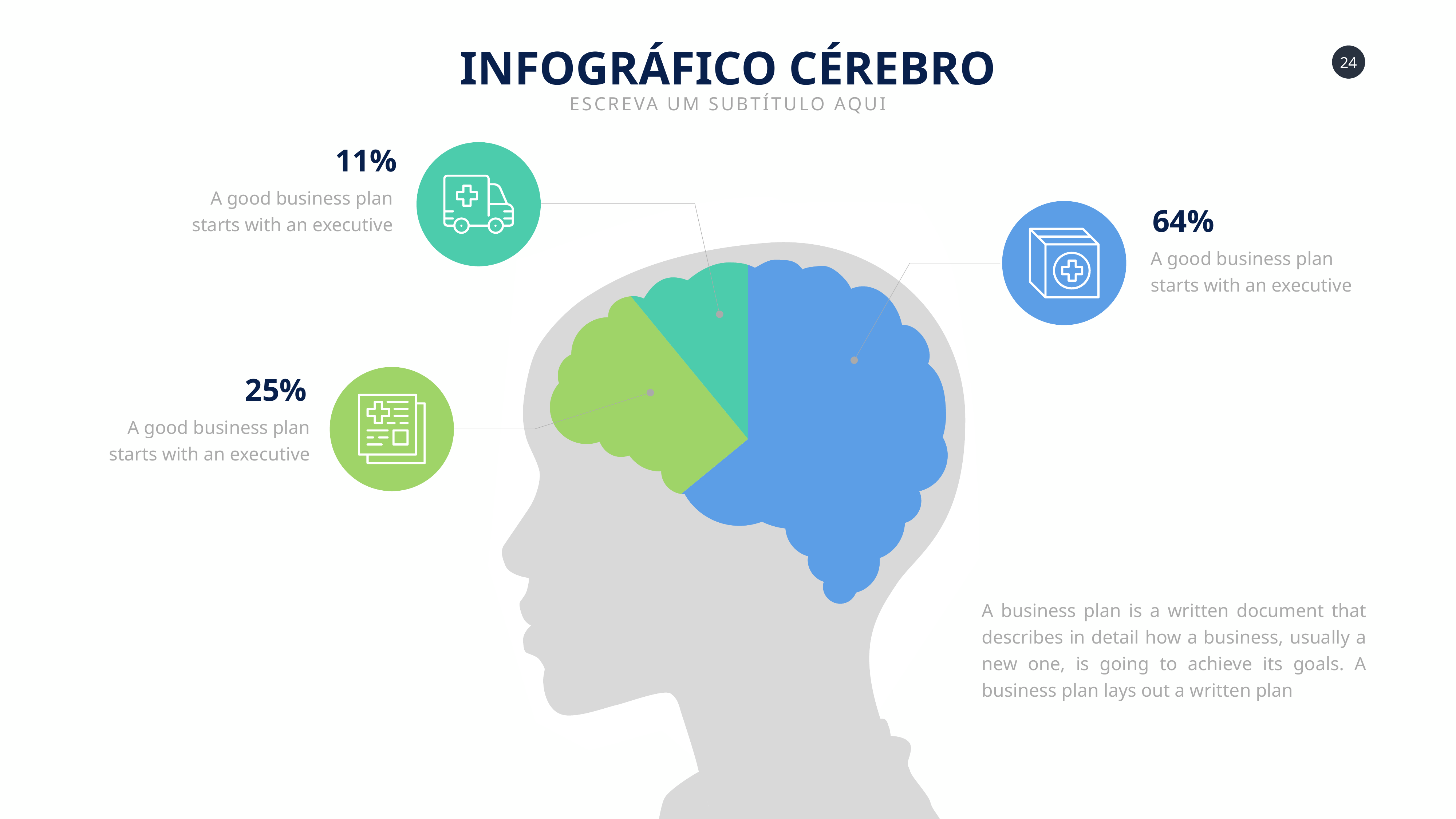
What is the difference between the blue segment's percentage and the green segment's percentage? 39% What is the difference between the green segment's percentage and the teal segment's percentage? 14% What is the title of the slide? INFOGRÁFICO CÉREBRO What do the three percentages on the slide add up to? 100% What percentage is shown for the teal segment of the brain (linked to the ambulance icon)? 11% What colour is the segment of the brain labelled 64%? Blue What percentage is shown for the green segment of the brain (linked to the document icon)? 25% Which is larger, the green segment's percentage or the teal segment's percentage? The green segment (25%) Which segment of the brain has the largest percentage? The blue segment (64%) What percentage is shown for the blue segment of the brain (linked to the medical box icon)? 64% How many segments is the brain divided into? 3 Which segment of the brain has the smallest percentage? The teal segment (11%)